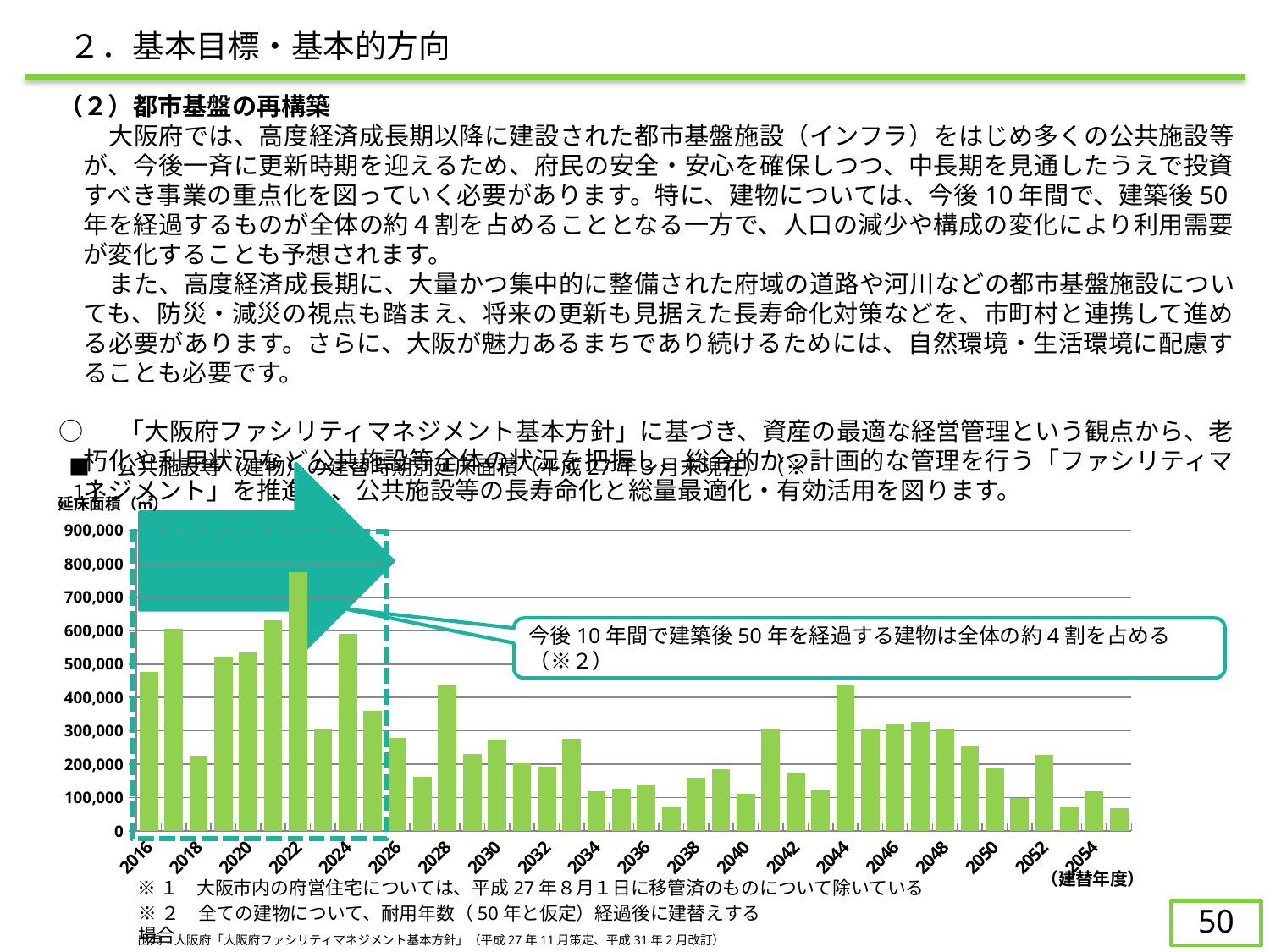
Is the value for 2034 greater or less than 200,000? less What kind of chart is shown on the slide? bar chart Which is larger, the value for 2028 or the value for 2030? 2028 Which is larger, the value for 2022 or the value for 2024? 2022 Is the value for 2018 greater or less than 300,000? less What is the label on the vertical axis of the chart? 延床面積（㎡） Which rebuild year (建替年度) has the highest floor area? 2022 Is the value for 2016 greater or less than 400,000? greater What does the callout box on the chart say? 今後10年間で建築後50年を経過する建物は全体の約4割を占める（※2）